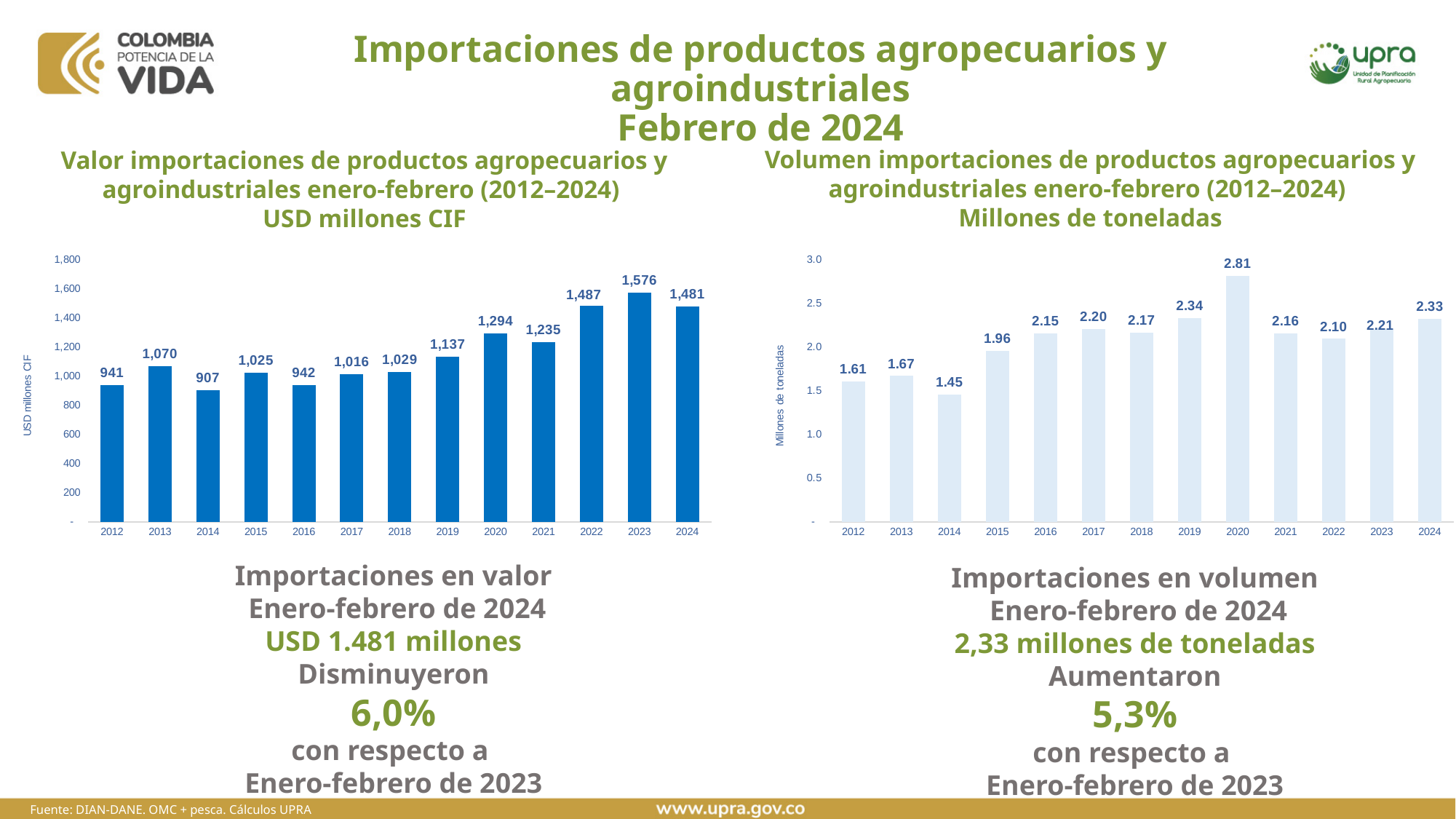
In the left chart (Valor importaciones, USD millones CIF), what is the difference between the values for 2023 and 2024? 95 In the left chart (Valor importaciones, USD millones CIF), what is the value for 2024? 1,481 In the left chart (Valor importaciones, USD millones CIF), which year has the highest value? 2023 In the right chart (Volumen importaciones, Millones de toneladas), which year has the lowest value? 2014 In the right chart (Volumen importaciones, Millones de toneladas), which year has a larger value, 2019 or 2022? 2019 What is the y-axis label of the left chart (Valor importaciones)? USD millones CIF In the left chart (Valor importaciones, USD millones CIF), which year has a larger value, 2020 or 2021? 2020 In the left chart (Valor importaciones, USD millones CIF), which year has the lowest value? 2014 In the right chart (Volumen importaciones, Millones de toneladas), what is the difference between the values for 2024 and 2023? 0.12 In the right chart (Volumen importaciones, Millones de toneladas), what is the value for 2020? 2.81 What kind of chart is the right chart (Volumen importaciones, Millones de toneladas)? bar chart In the left chart (Valor importaciones, USD millones CIF), how many years are plotted? 13